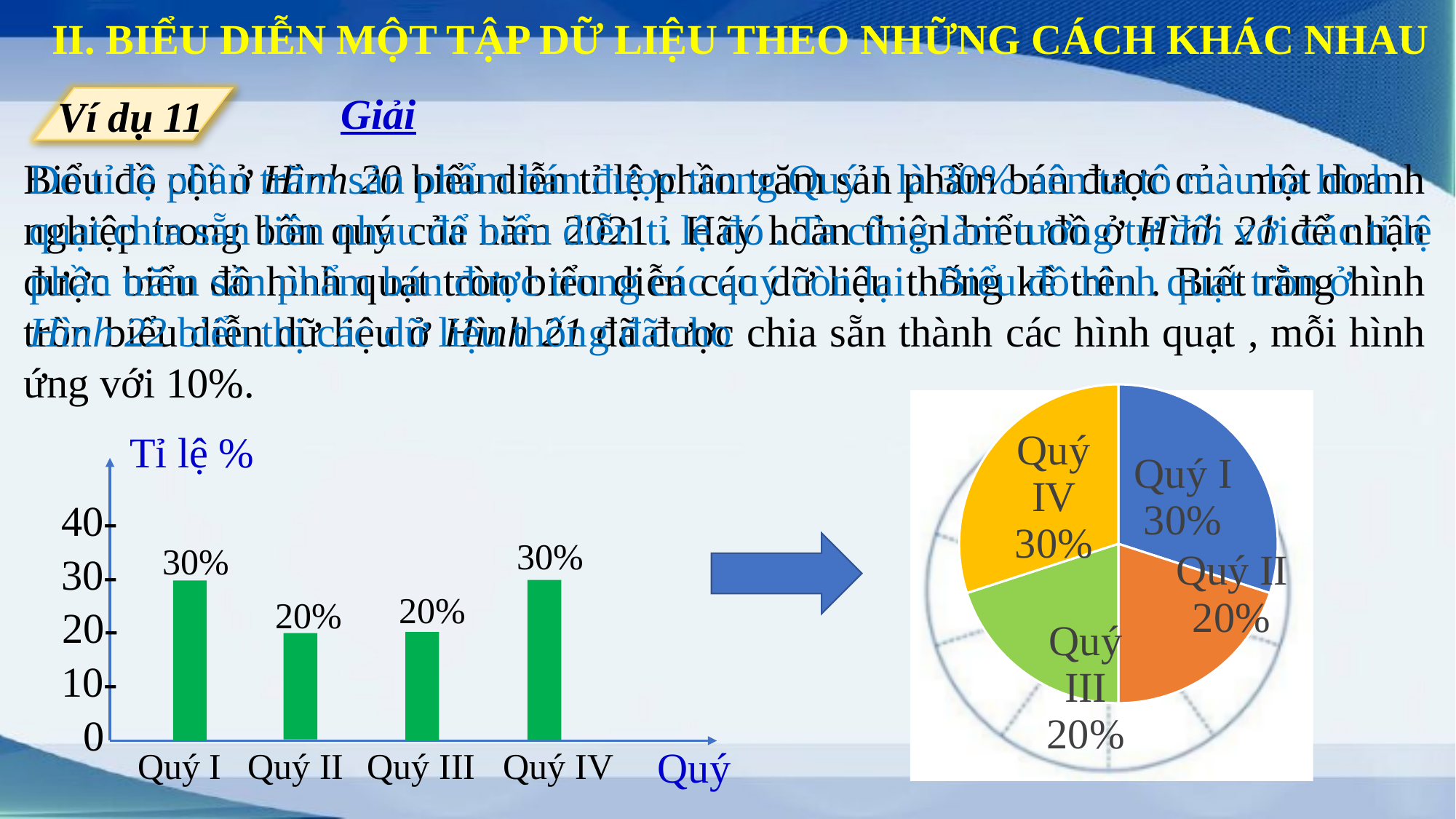
In the pie chart on the right, what share does Quý I have? 30% In the pie chart on the right, what share does Quý III have? 20% What is the label on the vertical axis of the bar chart on the left? Tỉ lệ % In the bar chart on the left, what is the value for Quý IV? 30% In the bar chart on the left, is the value for Quý IV greater or less than 20? greater How many categories are shown in the bar chart on the left? 4 In the bar chart on the left, what is the value for Quý II? 20% What kind of chart is the chart on the left of the slide? bar chart What kind of chart is the chart on the right of the slide? pie chart How many slices does the pie chart on the right have? 4 In the bar chart on the left, what is the difference between the values for Quý I and Quý III? 10% In the bar chart on the left, which is larger, the value for Quý I or the value for Quý II? Quý I